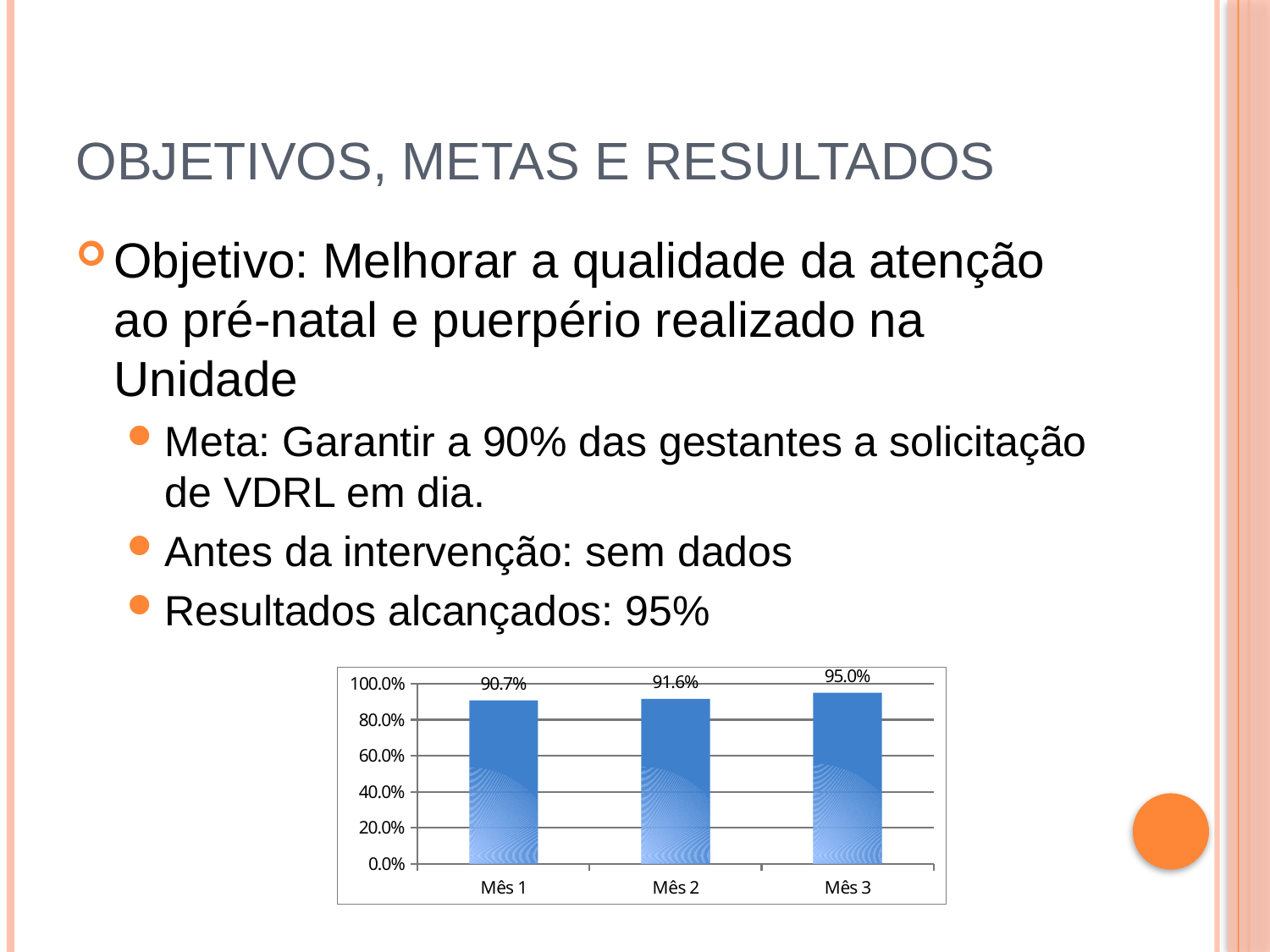
Which is larger, the value for Mês 3 or the value for Mês 2? Mês 3 What is the difference between the values for Mês 2 and Mês 1? 0.9% Is the value for Mês 1 greater or less than 80.0%? greater What is the value for Mês 2? 91.6% What is the difference between the values for Mês 3 and Mês 1? 4.3% How many categories are shown on the x axis? 3 What is the value for Mês 3? 95.0% Which month has the highest value? Mês 3 What is the value for Mês 1? 90.7% Which month has the lowest value? Mês 1 What kind of chart is shown on the slide? bar chart Do the values rise or fall from Mês 1 to Mês 3? rise